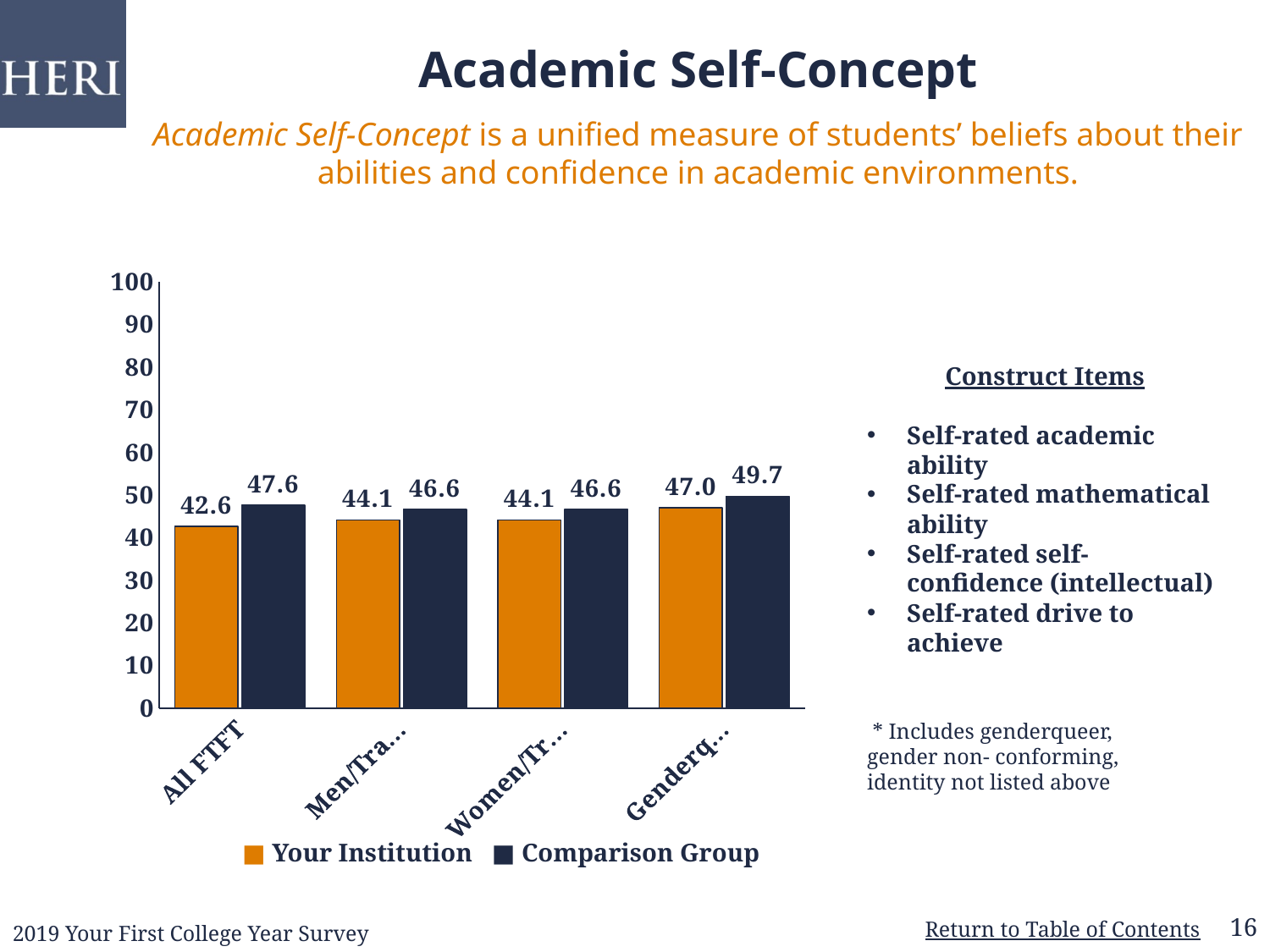
For All FTFT, which is larger: Your Institution or Comparison Group? Comparison Group What kind of chart is shown on the slide? bar chart What is the Comparison Group value for All FTFT? 47.6 How many categories are shown on the x axis? 4 What is the difference between the Comparison Group and Your Institution values for All FTFT? 5.0 What is the Comparison Group value for the rightmost category? 49.7 How many series does the legend list? 2 What is the Your Institution value for All FTFT? 42.6 Which category has the lowest Your Institution value? All FTFT What is the Your Institution value for the rightmost category? 47.0 For the rightmost category, what is the difference between the Comparison Group and Your Institution values? 2.7 Is the Your Institution value for All FTFT greater or less than 50? less